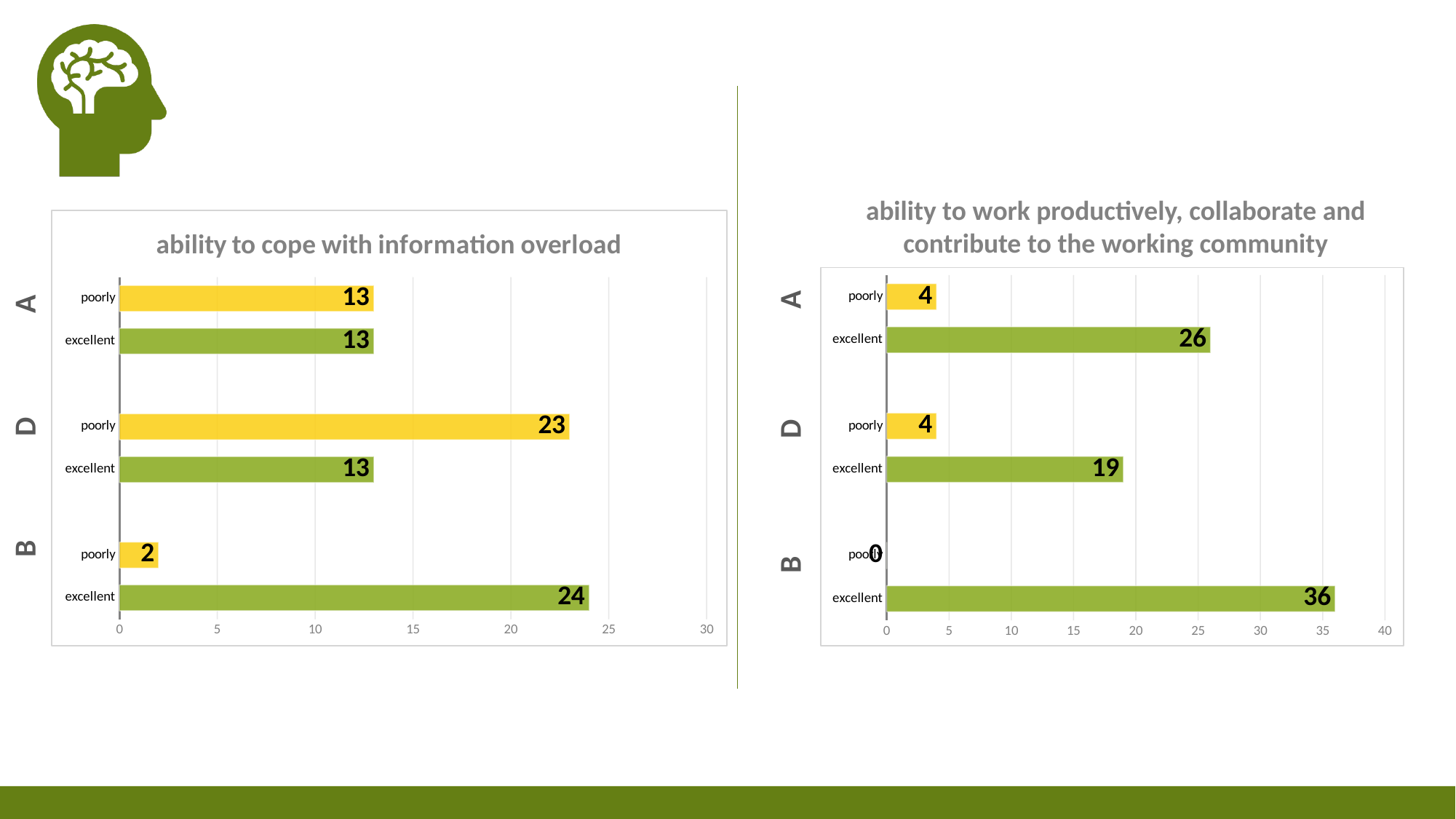
In the chart titled "ability to work productively, collaborate and contribute to the working community", which bar has the highest value? excellent in group B In the chart titled "ability to work productively, collaborate and contribute to the working community", what is the value for "excellent" in group A? 26 In the chart titled "ability to cope with information overload", which bar has the lowest value? poorly in group B In the chart titled "ability to work productively, collaborate and contribute to the working community", is the "excellent" value in group A larger than the "excellent" value in group D? Yes In the chart titled "ability to cope with information overload", what is the difference between the "poorly" and "excellent" values in group D? 10 In the chart titled "ability to cope with information overload", is the "poorly" value in group A larger or smaller than the "excellent" value in group A? They are equal What type of chart is the chart titled "ability to cope with information overload"? Bar chart In the chart titled "ability to work productively, collaborate and contribute to the working community", what is the value for "poorly" in group B? 0 In the chart titled "ability to work productively, collaborate and contribute to the working community", what is the difference between the "excellent" values of group B and group D? 17 In the chart titled "ability to work productively, collaborate and contribute to the working community", what is the maximum value shown on the horizontal axis? 40 In the chart titled "ability to cope with information overload", what is the value for "excellent" in group B? 24 In the chart titled "ability to cope with information overload", what is the value for "poorly" in group D? 23